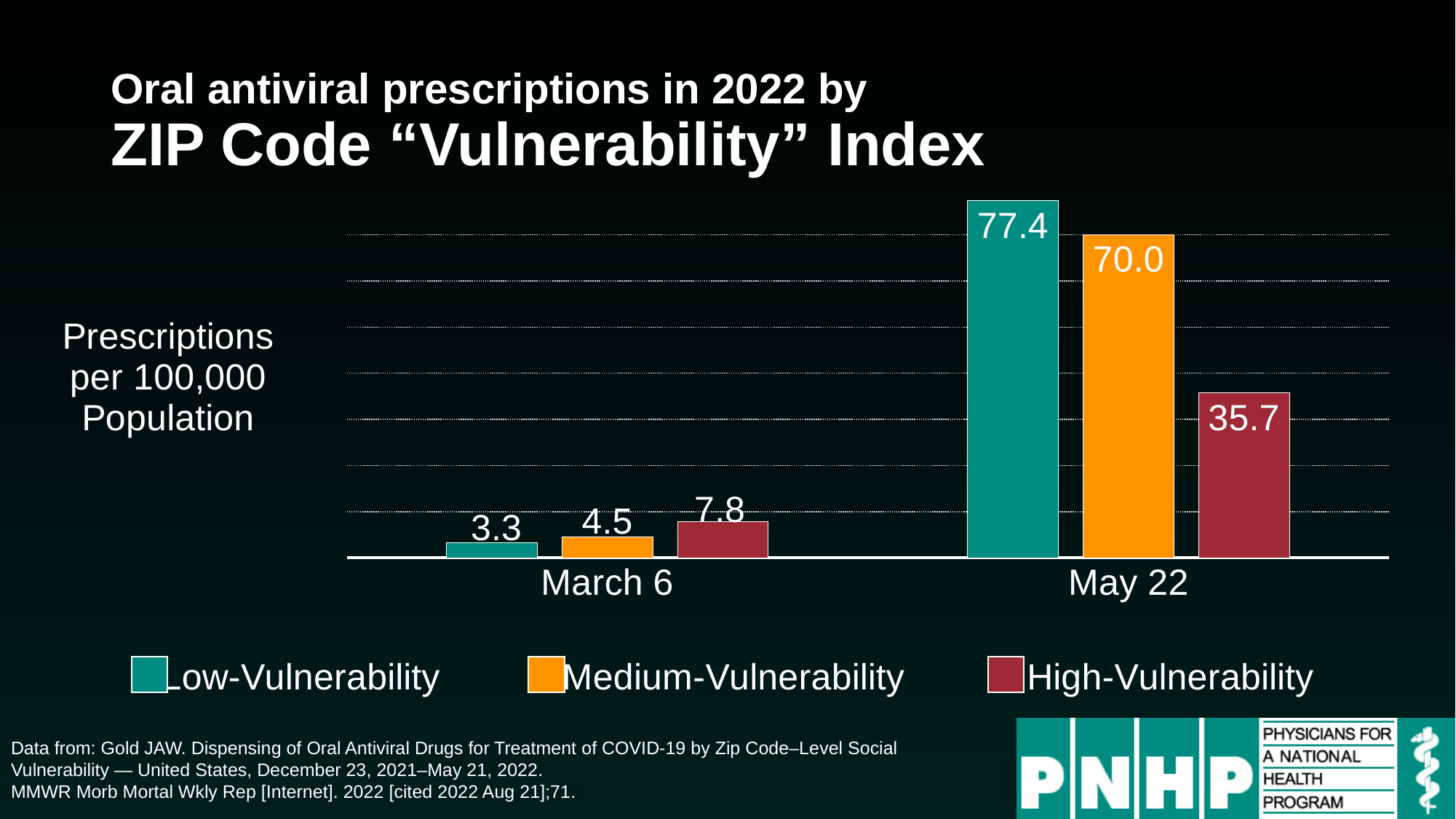
Which is larger on March 6: Medium-Vulnerability or High-Vulnerability? High-Vulnerability What kind of chart is shown on the slide? Bar chart What is the value for High-Vulnerability on March 6? 7.8 Which vulnerability group has the highest value on May 22? Low-Vulnerability What is the value for Medium-Vulnerability on May 22? 70.0 What is the value for Low-Vulnerability on March 6? 3.3 How many date categories are shown on the x axis? 2 What colour represents Medium-Vulnerability in the legend? Orange Which vulnerability group has the lowest value on March 6? Low-Vulnerability How many series does the legend list? 3 Do the High-Vulnerability values rise or fall from March 6 to May 22? Rise What is the difference between the Low-Vulnerability and High-Vulnerability values on May 22? 41.7